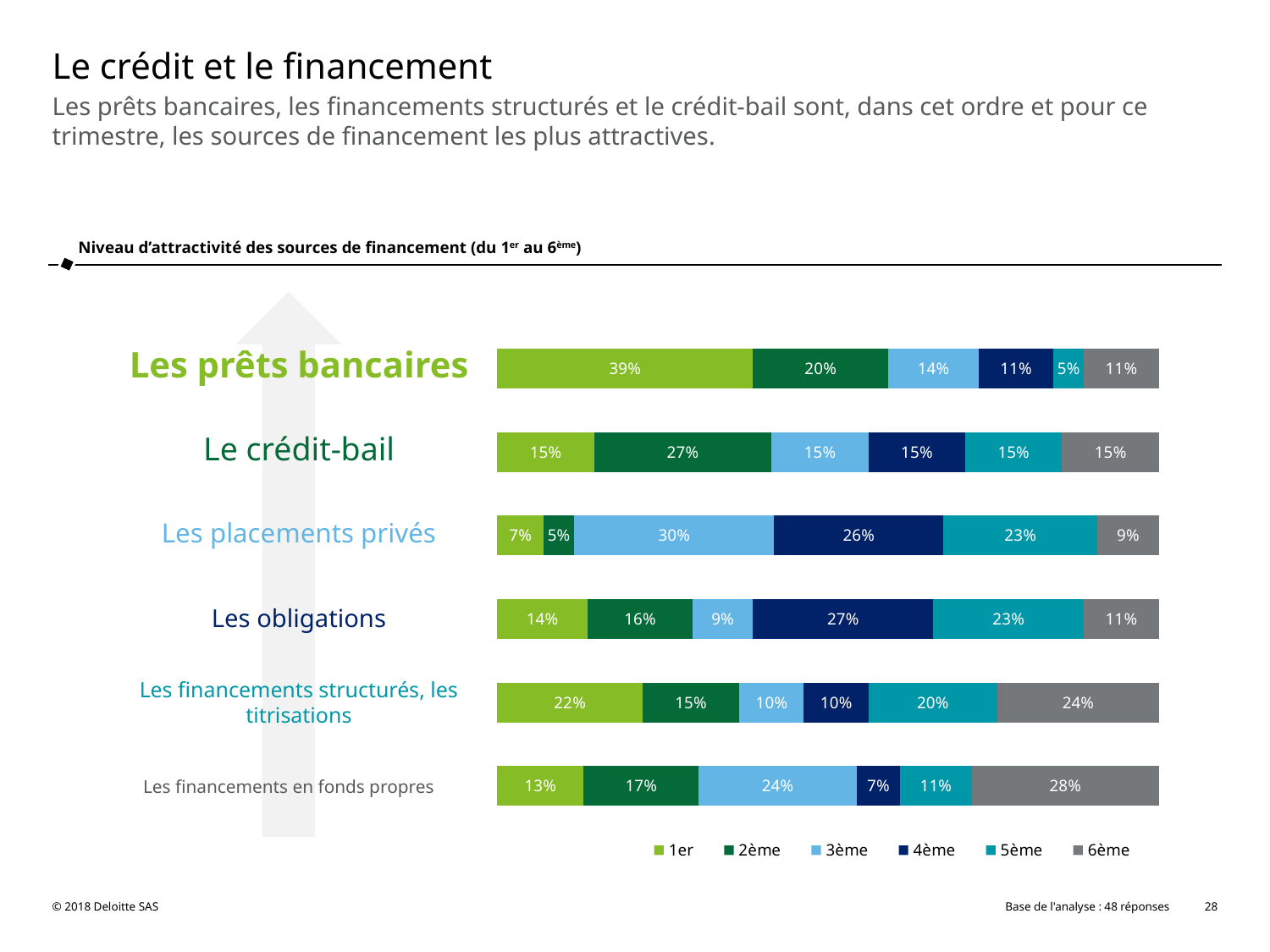
What is the difference between the '1er' values of Les prêts bancaires and Les financements structurés, les titrisations? 17 percentage points Which financing source has the lowest '1er' value? Les placements privés What kind of chart is shown on the slide? Stacked bar chart How many series does the legend list? 6 How many financing sources (categories) are shown in the chart? 6 Which financing source has the highest '1er' value? Les prêts bancaires What is the '6ème' value for Les financements en fonds propres? 28% What is the '1er' value for Les prêts bancaires? 39% What is the '2ème' value for Le crédit-bail? 27% Which is larger: the '3ème' value for Les placements privés or the '3ème' value for Les obligations? Les placements privés What is the total of the stacked bar for Les prêts bancaires? 100% What is the title of the chart? Niveau d'attractivité des sources de financement (du 1er au 6ème)